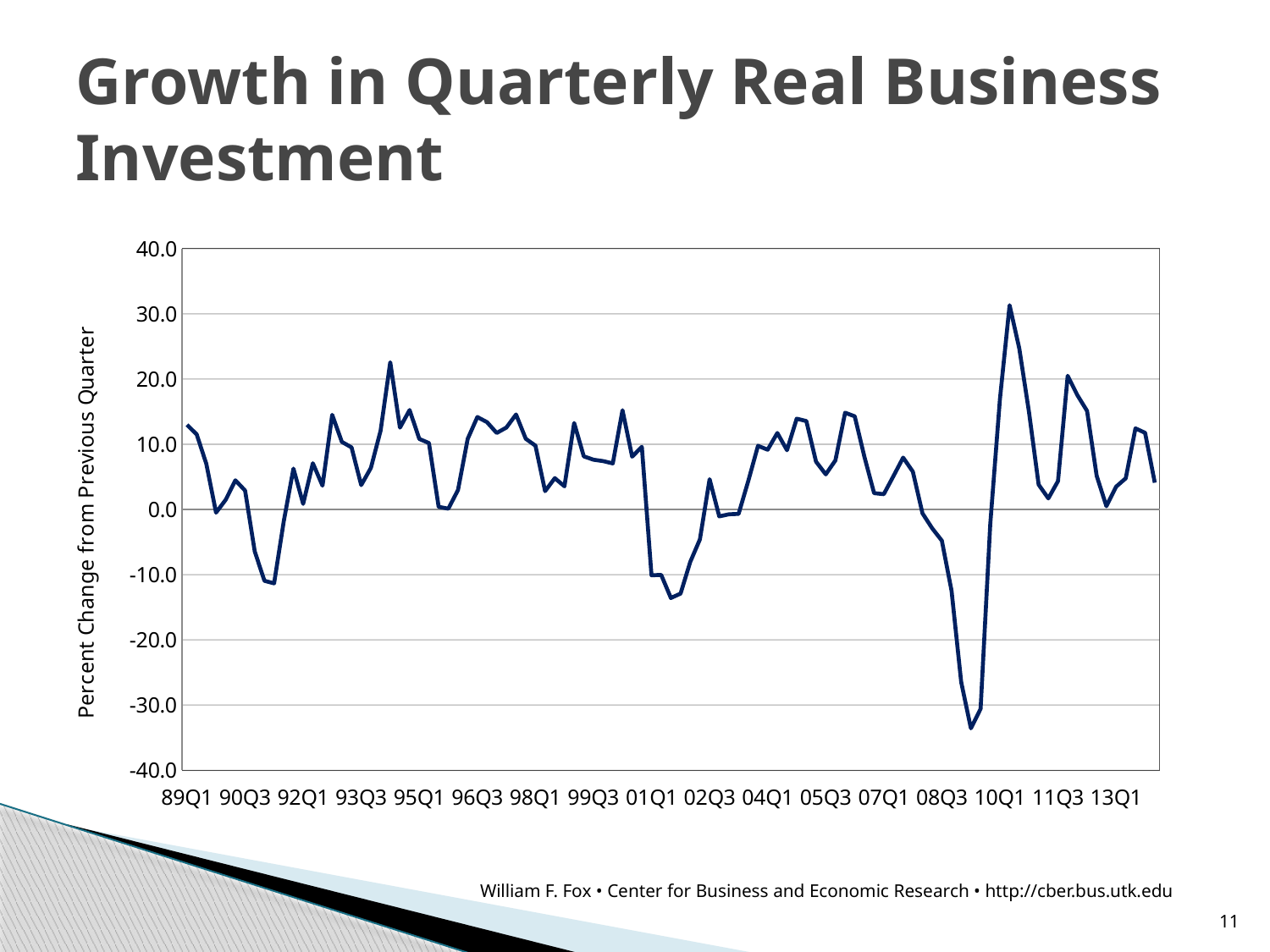
Is the value at 89Q1 greater or less than 10.0? greater What is the title of the chart on the slide? Growth in Quarterly Real Business Investment How many quarter labels are printed along the horizontal axis? 17 Is the value at 95Q1 greater or less than 0.0? greater Is the lowest value on the line greater or less than -30.0? less Which is larger, the value at 89Q1 or the lowest value on the line? 89Q1 What is the label on the vertical axis of the chart? Percent Change from Previous Quarter Does the line fall or rise between 08Q3 and its lowest point? fall What is the highest value shown on the vertical axis? 40.0 What kind of chart is shown on the slide? line chart